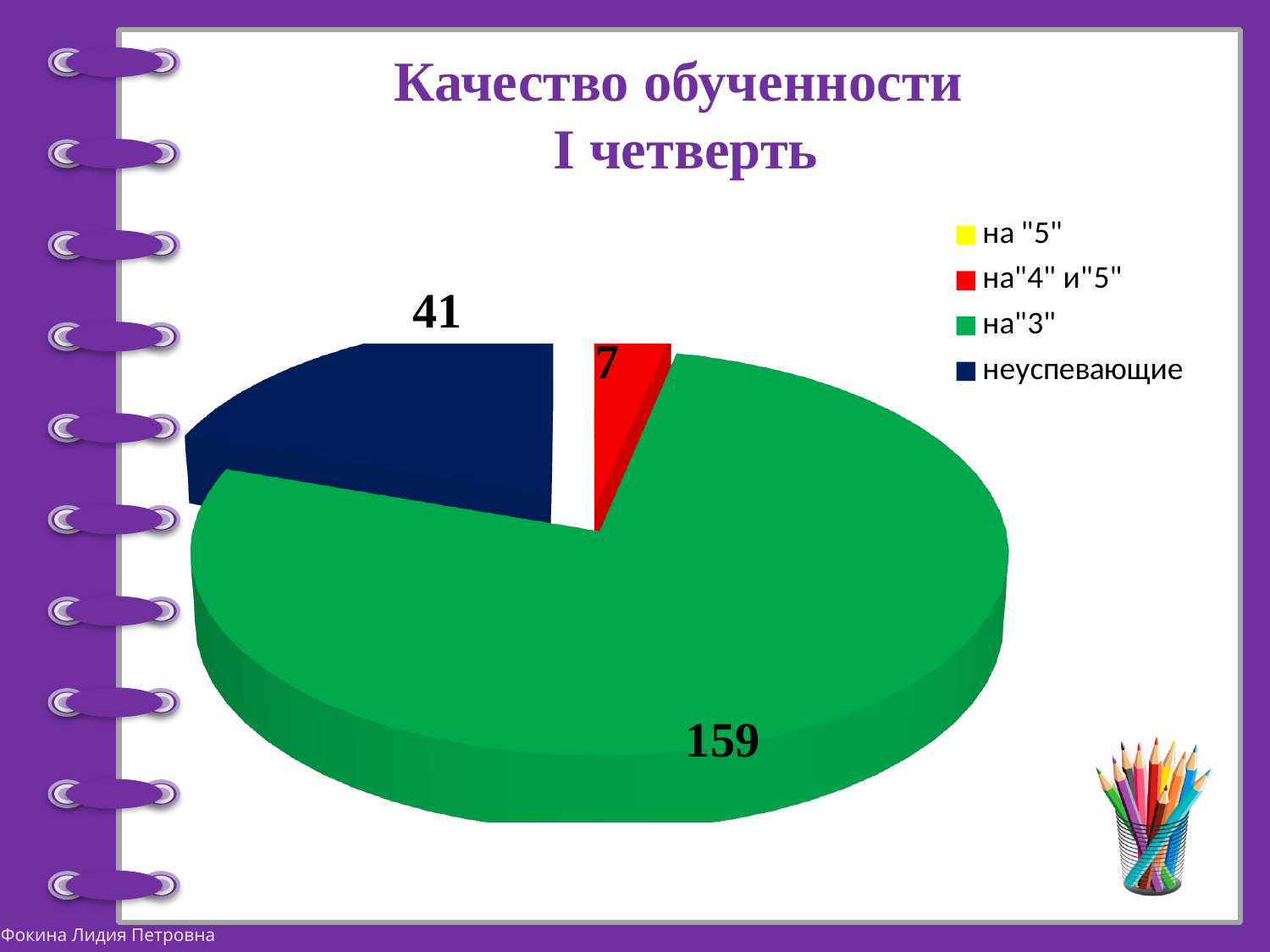
What is the difference between the value for на"3" and the value for неуспевающие? 118 What is the value for на"3"? 159 What is the title of the chart? Качество обученности I четверть What is the difference between the value for неуспевающие and the value for на"4" и"5"? 34 How many entries does the legend list? 4 What colour is the slice for неуспевающие? dark blue What is the value for на"4" и"5"? 7 What is the value for неуспевающие? 41 Which is larger, the value for на"3" or the value for неуспевающие? на"3" Which category has the largest slice of the pie? на"3" Which is larger, the value for неуспевающие or the value for на"4" и"5"? неуспевающие What kind of chart is shown on the slide? pie chart